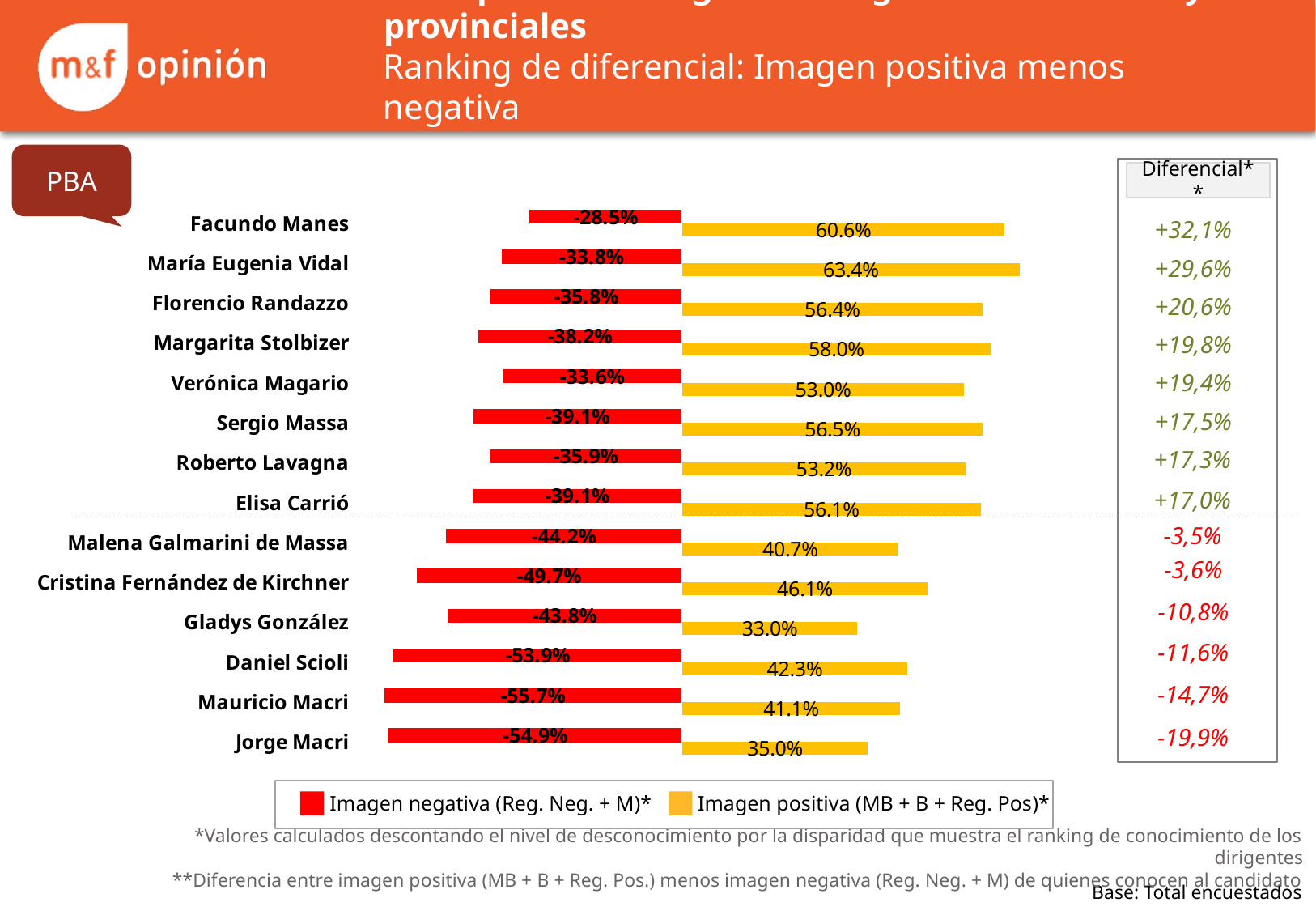
How many series does the legend list? 2 What is the Diferencial value shown for Facundo Manes? +32,1% Which candidate has the lowest Imagen positiva value? Gladys González Who has the larger Imagen positiva value, Sergio Massa or Roberto Lavagna? Sergio Massa Which colour represents Imagen negativa in the chart? Red What kind of chart is shown on the slide? Bar chart What is the difference between the Imagen positiva values of María Eugenia Vidal and Facundo Manes? 2.8% Which candidate has the highest Imagen positiva value? María Eugenia Vidal What is the Imagen positiva value for Jorge Macri? 35.0% What is the Imagen negativa value for María Eugenia Vidal? -33.8% How many candidates are shown in the chart? 14 What is the Imagen positiva value for Facundo Manes? 60.6%